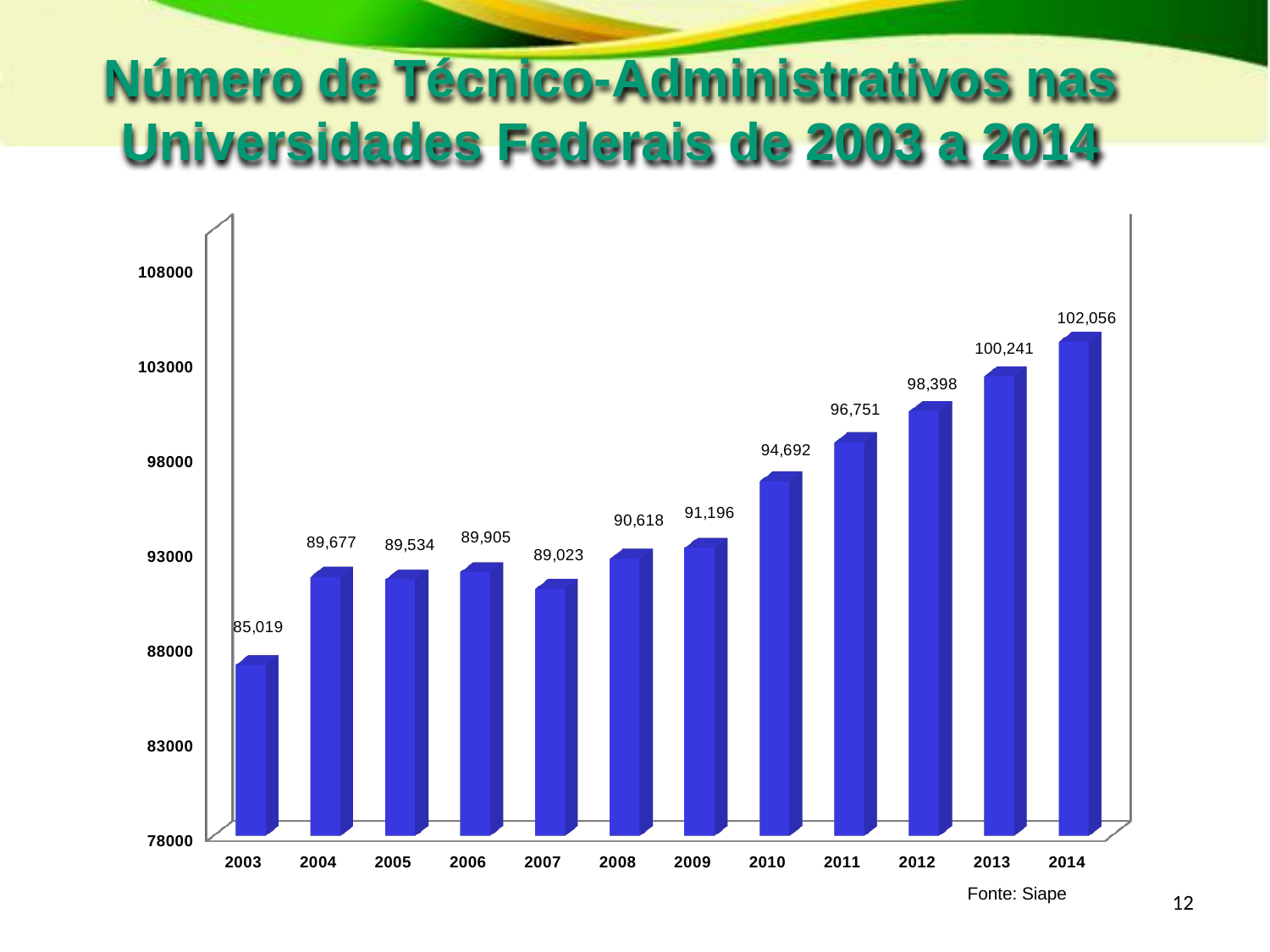
How many years are shown on the x axis? 12 Which year has the lowest value? 2003 What value is shown for 2010? 94,692 What is the difference between the values for 2013 and 2012? 1,843 What is the value for 2014? 102,056 Which is larger, the value for 2008 or the value for 2007? 2008 What kind of chart is shown on the slide? bar chart Which year has the highest value? 2014 Is the value for 2011 greater or less than 98000? less What is the difference between the values for 2014 and 2003? 17,037 Do the values generally rise or fall from 2003 to 2014? rise What is the number of técnico-administrativos in 2003? 85,019